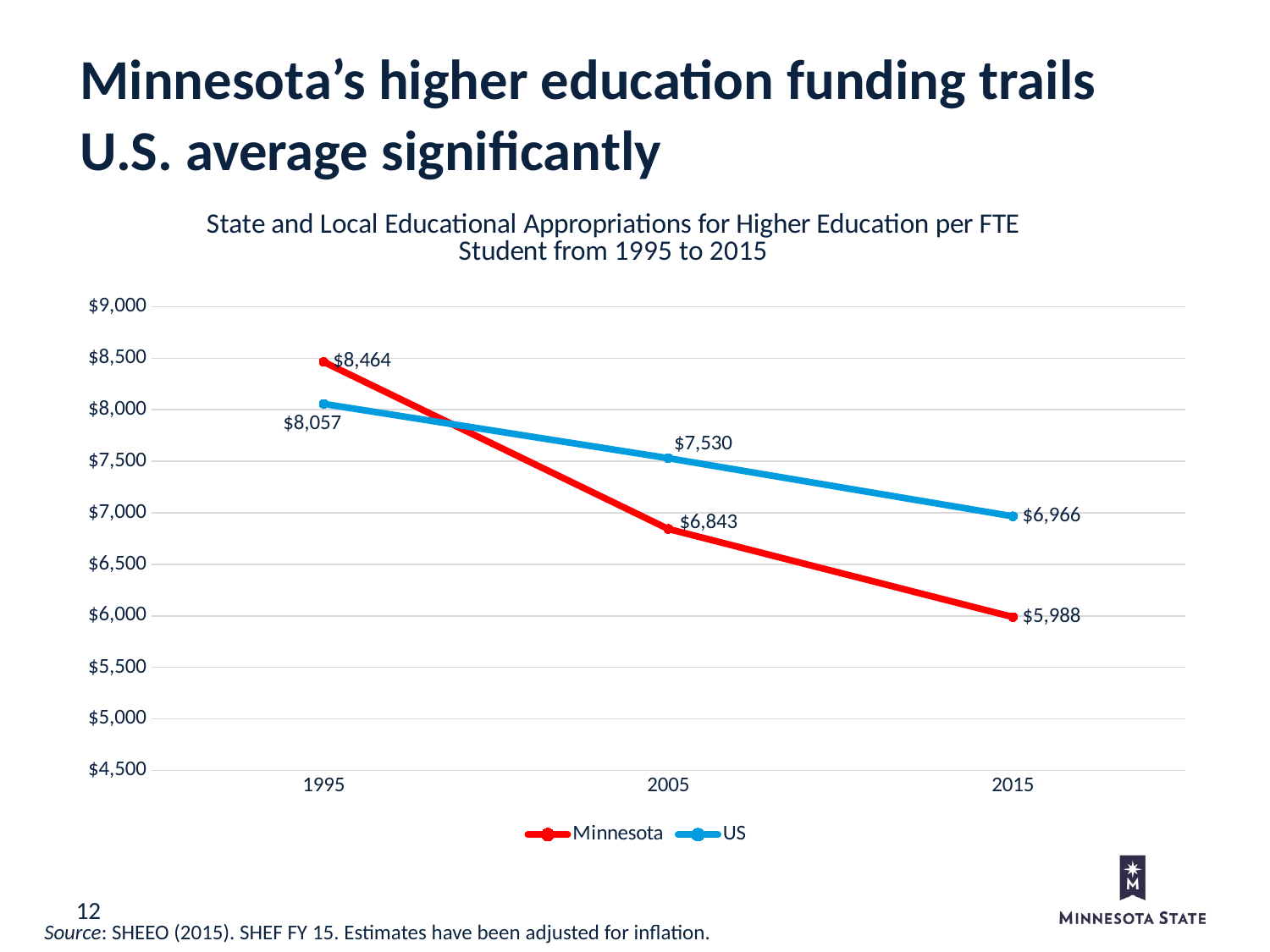
How many series does the legend list? 2 What is the value for Minnesota in 1995? $8,464 In which year is the Minnesota value lowest? 2015 What is the value for Minnesota in 2015? $5,988 In which year is the US value highest? 1995 What is the value for US in 2005? $7,530 What kind of chart is shown? line chart Which is larger in 2005, Minnesota or US? US Is the value for Minnesota in 2005 greater or less than $7,000? less What is the difference between the US and Minnesota values in 2015? $978 How many years are shown on the x axis? 3 What is the value for US in 1995? $8,057